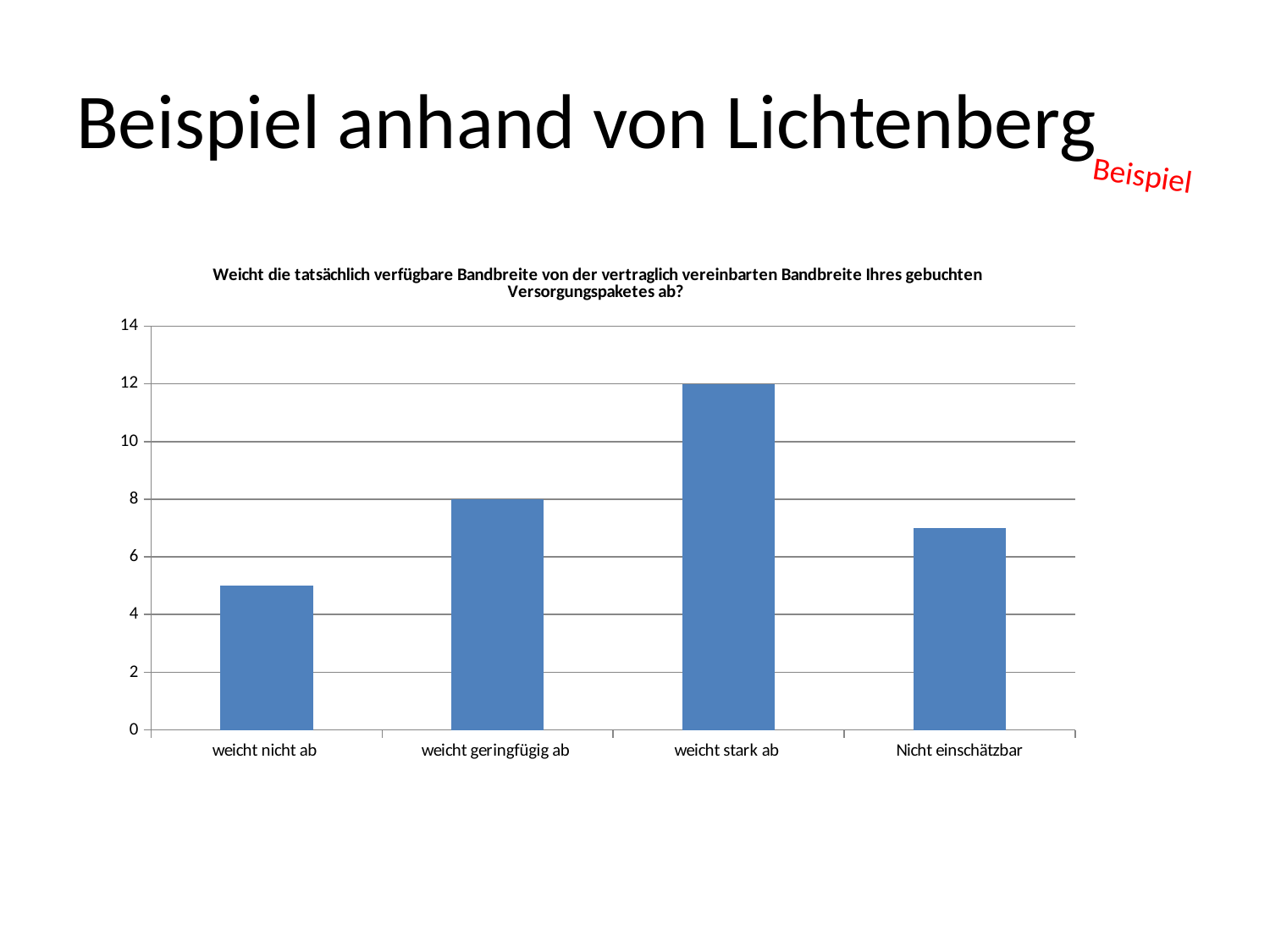
What is the value for "weicht geringfügig ab"? 8 What is the difference between the values for "weicht stark ab" and "weicht geringfügig ab"? 4 Which category has the lowest bar? weicht nicht ab What is the highest value shown on the vertical axis of the chart? 14 Which is larger, the value for "weicht geringfügig ab" or the value for "Nicht einschätzbar"? weicht geringfügig ab What is the value for "weicht stark ab"? 12 What kind of chart is shown on the slide? bar chart Which is larger, the value for "Nicht einschätzbar" or the value for "weicht nicht ab"? Nicht einschätzbar How many categories are shown on the x axis of the chart? 4 Is the value for "weicht nicht ab" greater or less than 6? less Is the value for "Nicht einschätzbar" greater or less than 6? greater Which category has the highest bar? weicht stark ab